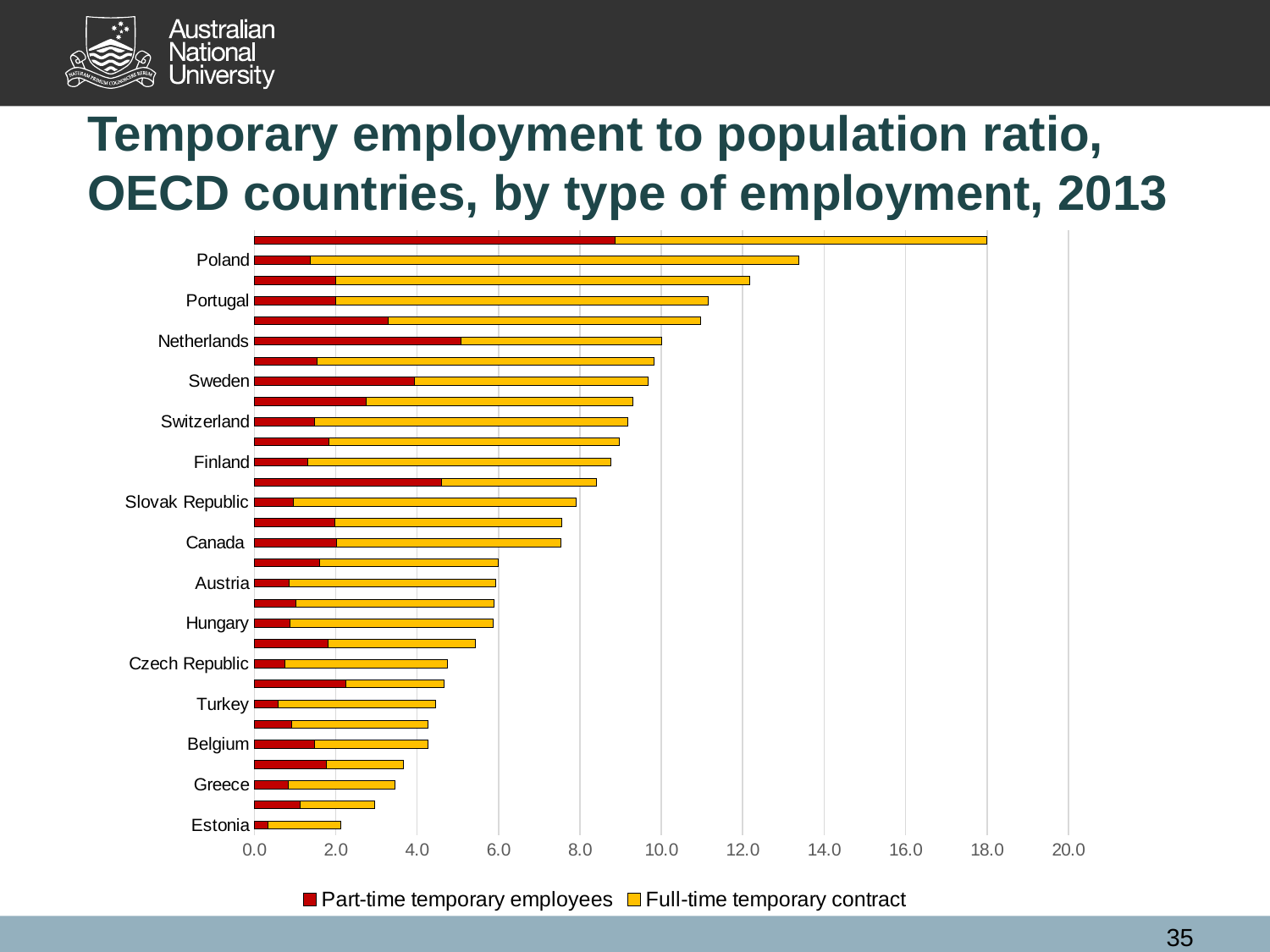
Which has the longer total bar, Greece or Estonia? Greece Is the total bar length for Finland greater or less than 8.0? greater How many series does the legend list? 2 What are the two series named in the legend? Part-time temporary employees; Full-time temporary contract Which country has the shortest total bar in the chart? Estonia Is the total bar length for Canada greater or less than 8.0? less Is the total bar length for Poland greater or less than 12.0? greater What type of chart is shown on the slide? Stacked horizontal bar chart What is the title of the chart? Temporary employment to population ratio, OECD countries, by type of employment, 2013 Which has the longer total bar, Poland or Portugal? Poland